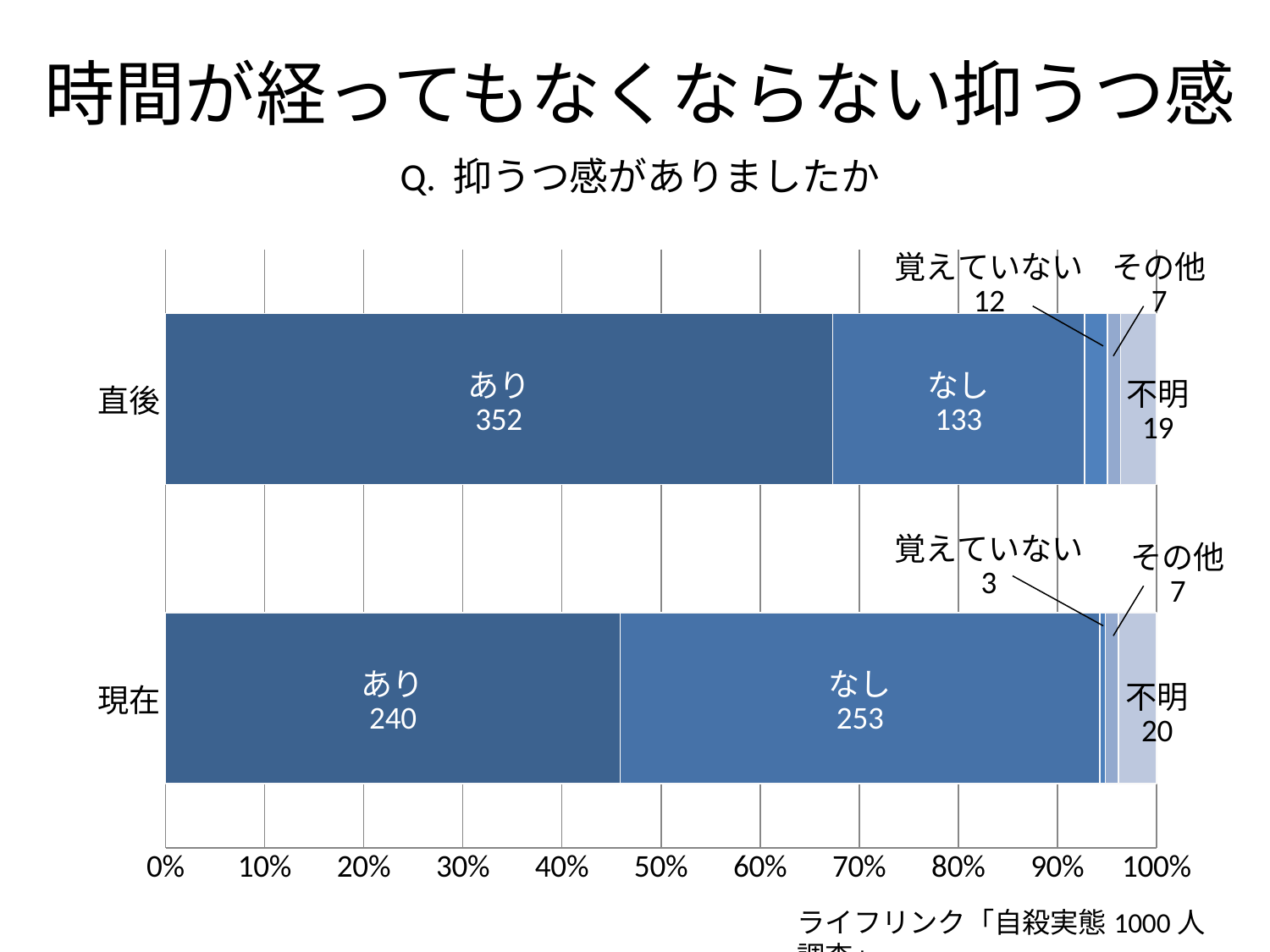
How many bars (categories) does the chart show? 2 Which segment is the smallest in the 現在 bar? 覚えていない Which is larger in the 現在 bar, あり or なし? なし What is the total of all segments in the 現在 bar? 523 Is the share of あり in the 直後 bar greater or less than 60%? greater What is the value for あり in the 直後 bar? 352 Which segment is the largest in the 直後 bar? あり What is the value for 覚えていない in the 現在 bar? 3 What is the difference between あり in 直後 and あり in 現在? 112 What kind of chart is shown on the slide? Stacked bar chart What is the value for なし in the 現在 bar? 253 What is the value for 不明 in the 直後 bar? 19